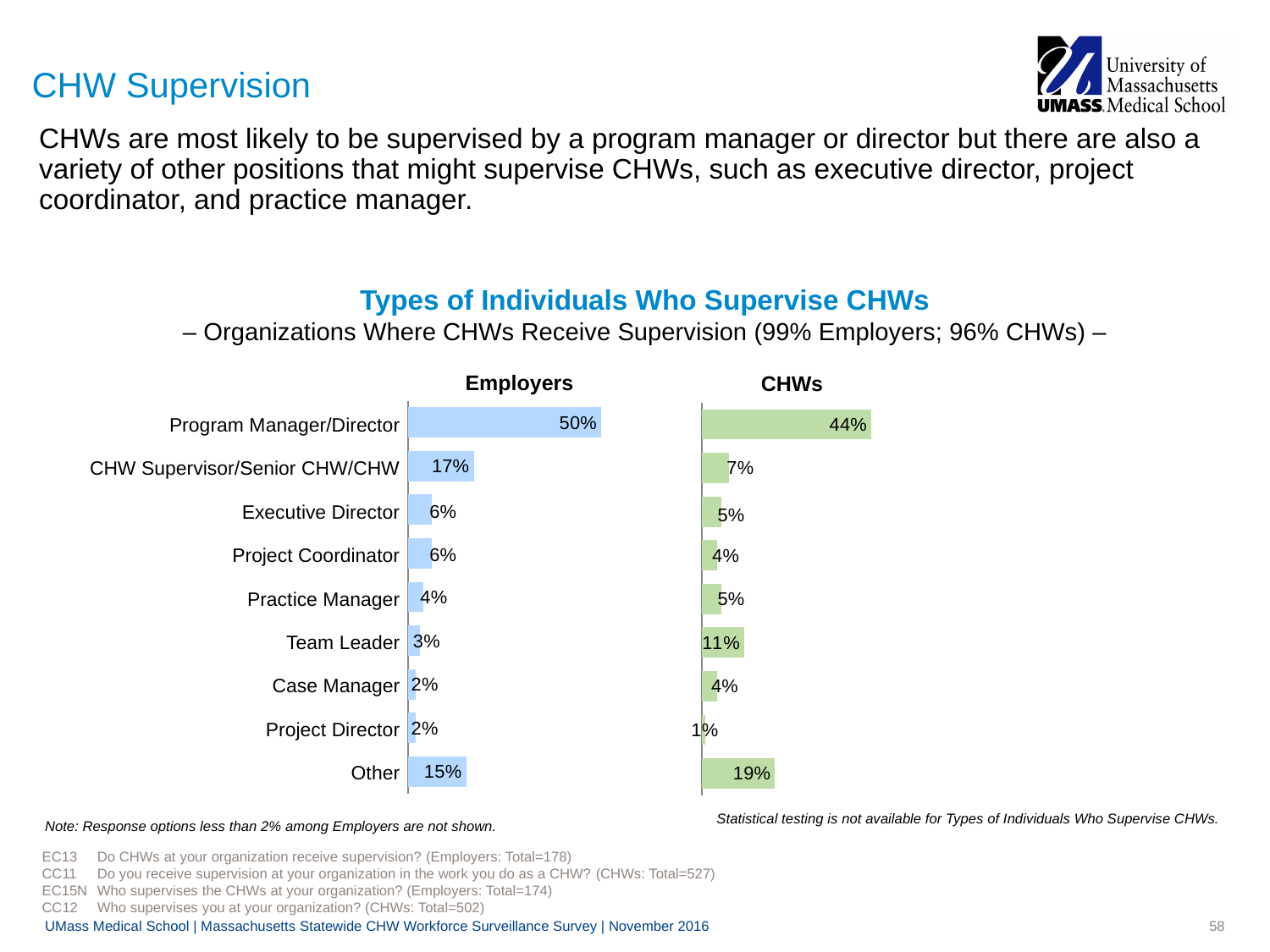
What is the difference between the Employers and CHWs values for Program Manager/Director? 6% In the Employers chart, what is the value for CHW Supervisor/Senior CHW/CHW? 17% In the Employers chart, what percentage of CHWs are supervised by a Program Manager/Director? 50% What is the title of the chart on the slide? Types of Individuals Who Supervise CHWs What type of chart is used for the Employers data? Bar chart In the CHWs chart, which category has the highest value? Program Manager/Director In the CHWs chart, what is the value for Other? 19% For Team Leader, which is larger: the Employers value or the CHWs value? CHWs In the CHWs chart, which category has the lowest value? Project Director In the Employers chart, what is the difference between Program Manager/Director and CHW Supervisor/Senior CHW/CHW? 33% How many categories are shown in the Employers chart? 9 In the CHWs chart, what is the value for Team Leader? 11%